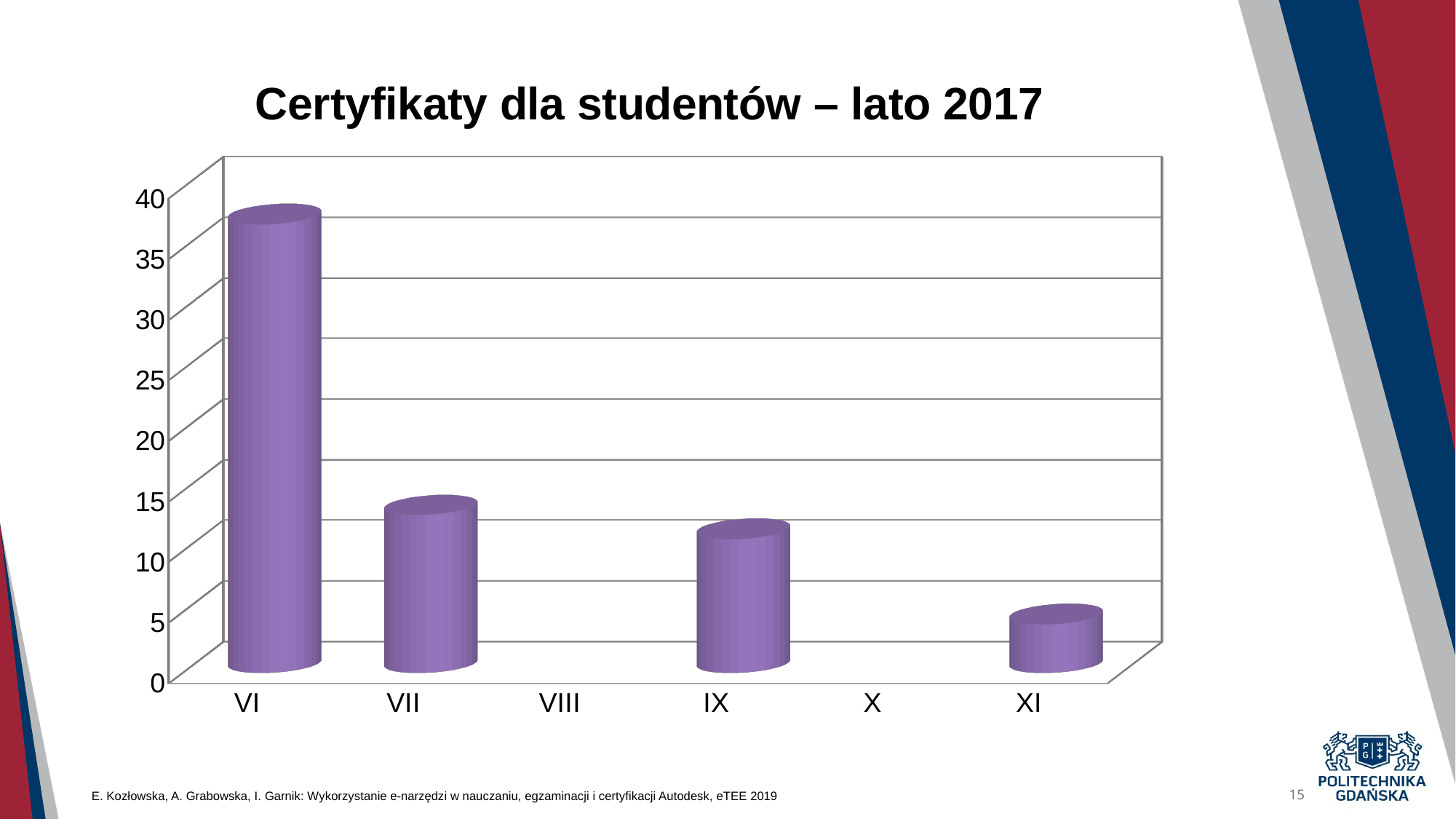
Among the categories with a visible bar, which has the lowest value? XI Which is larger, the value for VI or the value for VII? VI Is the value for XI greater or less than 10? less Which categories have no visible bar (a value of zero)? VIII and X Is the value for IX greater or less than 15? less Which category has the highest value? VI Which is larger, the value for IX or the value for XI? IX Is the value for VI greater or less than 30? greater What is the title of the chart? Certyfikaty dla studentów – lato 2017 What kind of chart is shown on the slide? bar chart How many categories are shown on the x axis? 6